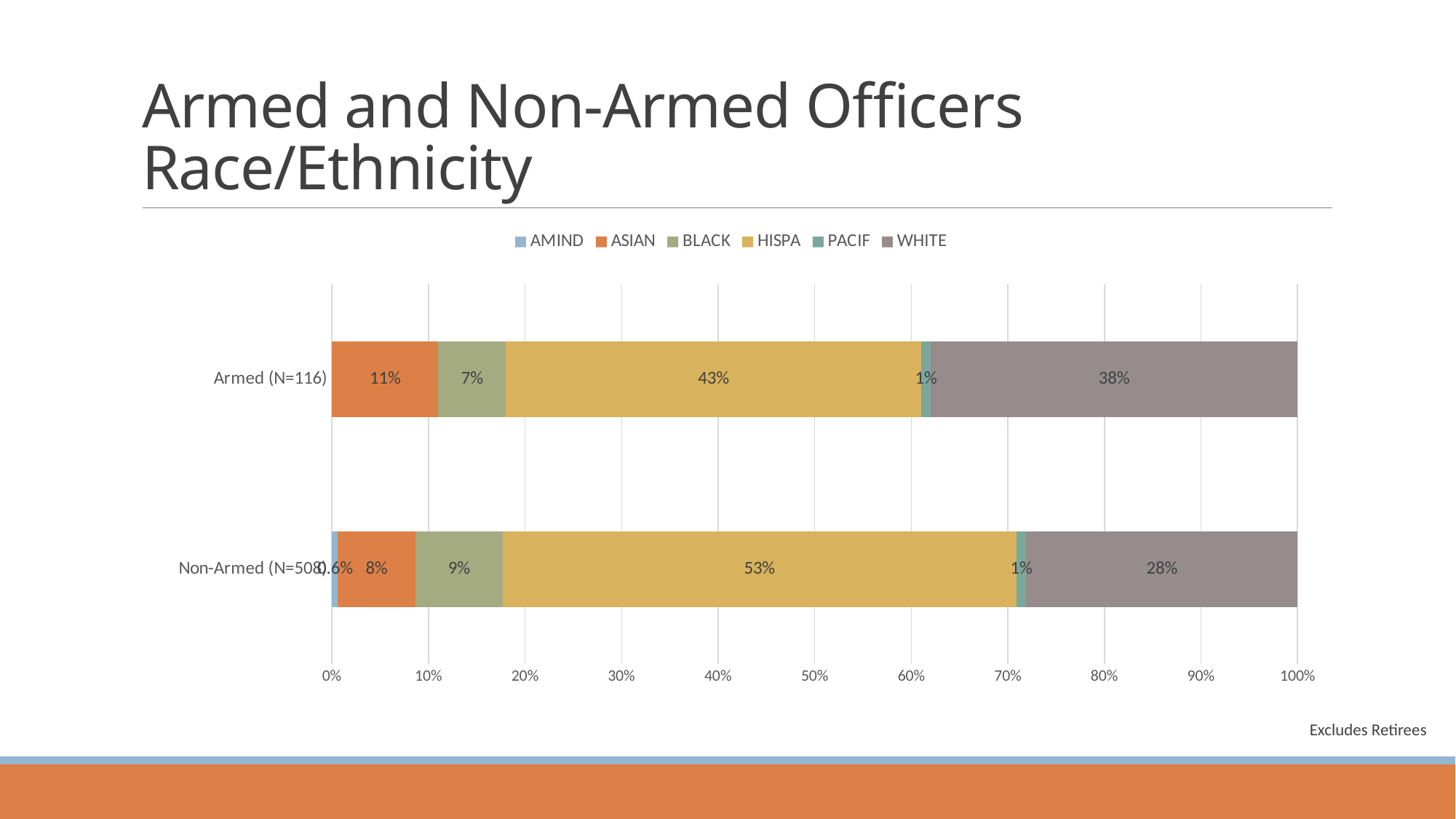
How many race/ethnicity series does the legend list? 6 Which group has a larger HISPA share, Armed or Non-Armed officers? Non-Armed What is the ASIAN share for Armed officers? 11% What percentage of Armed officers are HISPA? 43% What percentage of Non-Armed officers are WHITE? 28% How many percentage points higher is the HISPA share for Non-Armed officers than for Armed officers? 10 percentage points How many percentage points higher is the WHITE share for Armed officers than for Non-Armed officers? 10 percentage points Which race/ethnicity group has the largest share among Non-Armed officers? HISPA What type of chart is shown on the slide? Stacked bar chart Which race/ethnicity group has the largest share among Armed officers? HISPA How many officer groups (bars) are shown in the chart? 2 What is the BLACK share for Non-Armed officers? 9%